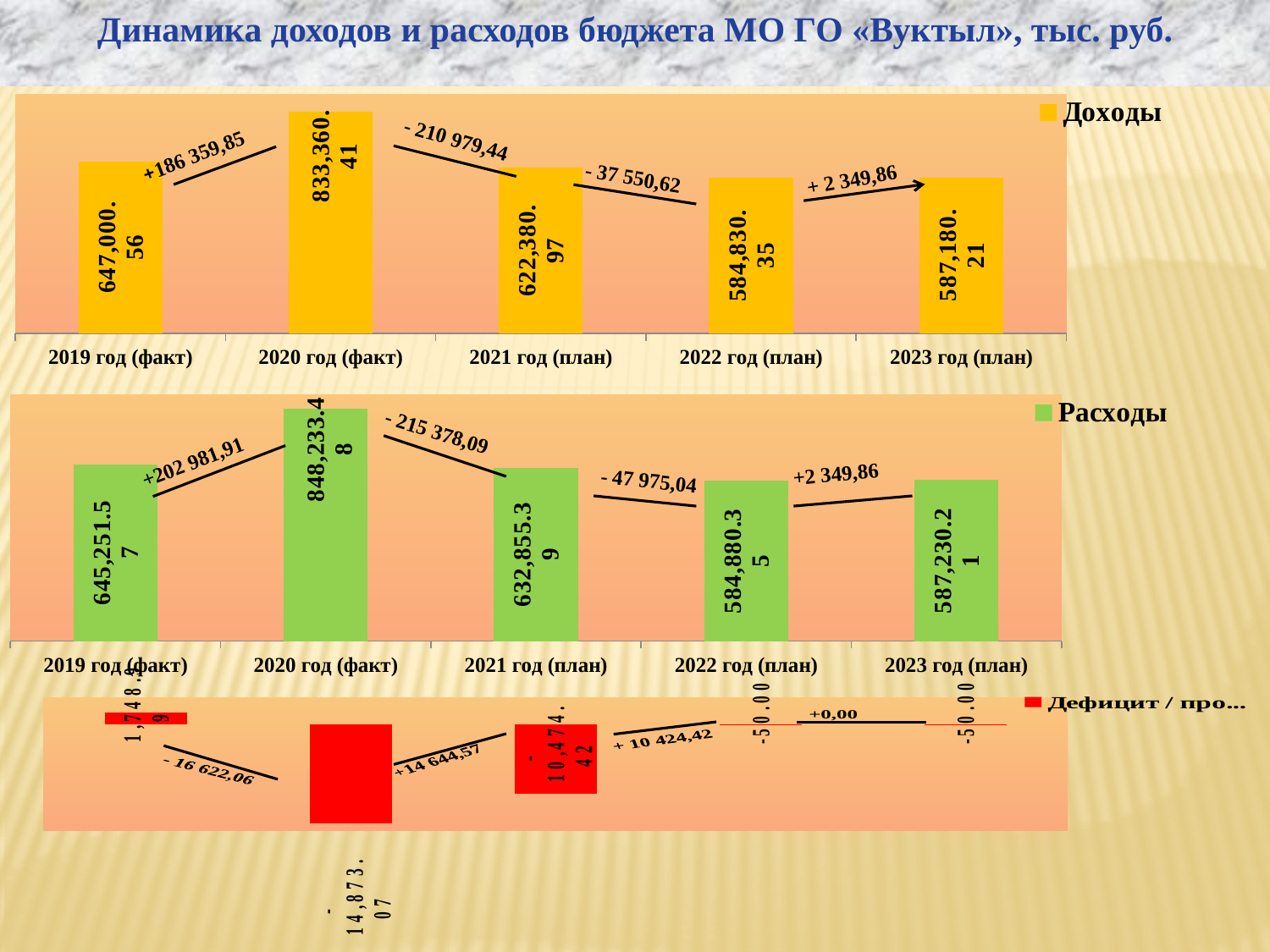
On the Расходы chart, what is the value for 2019 год (факт)? 645,251.57 On the Доходы chart, what is the value for 2020 год (факт)? 833,360.41 How many categories (years) are shown on the Доходы chart? 5 On the Доходы chart, what is the value for 2022 год (план)? 584,830.35 On the Расходы chart, what is the value for 2021 год (план)? 632,855.39 On the Расходы chart, what is the difference between the values for 2020 год (факт) and 2021 год (план)? 215,378.09 On the Доходы chart, which year has the lowest value? 2022 год (план) What type of chart is the Расходы chart? bar chart On the Доходы chart, which year has the highest value? 2020 год (факт) On the Расходы chart, which year has the highest value? 2020 год (факт) On the bottom chart (Дефицит / профицит), what is the value for 2020 год (факт)? -14,873.07 On the Доходы chart, which is larger: the value for 2019 год (факт) or the value for 2021 год (план)? 2019 год (факт)